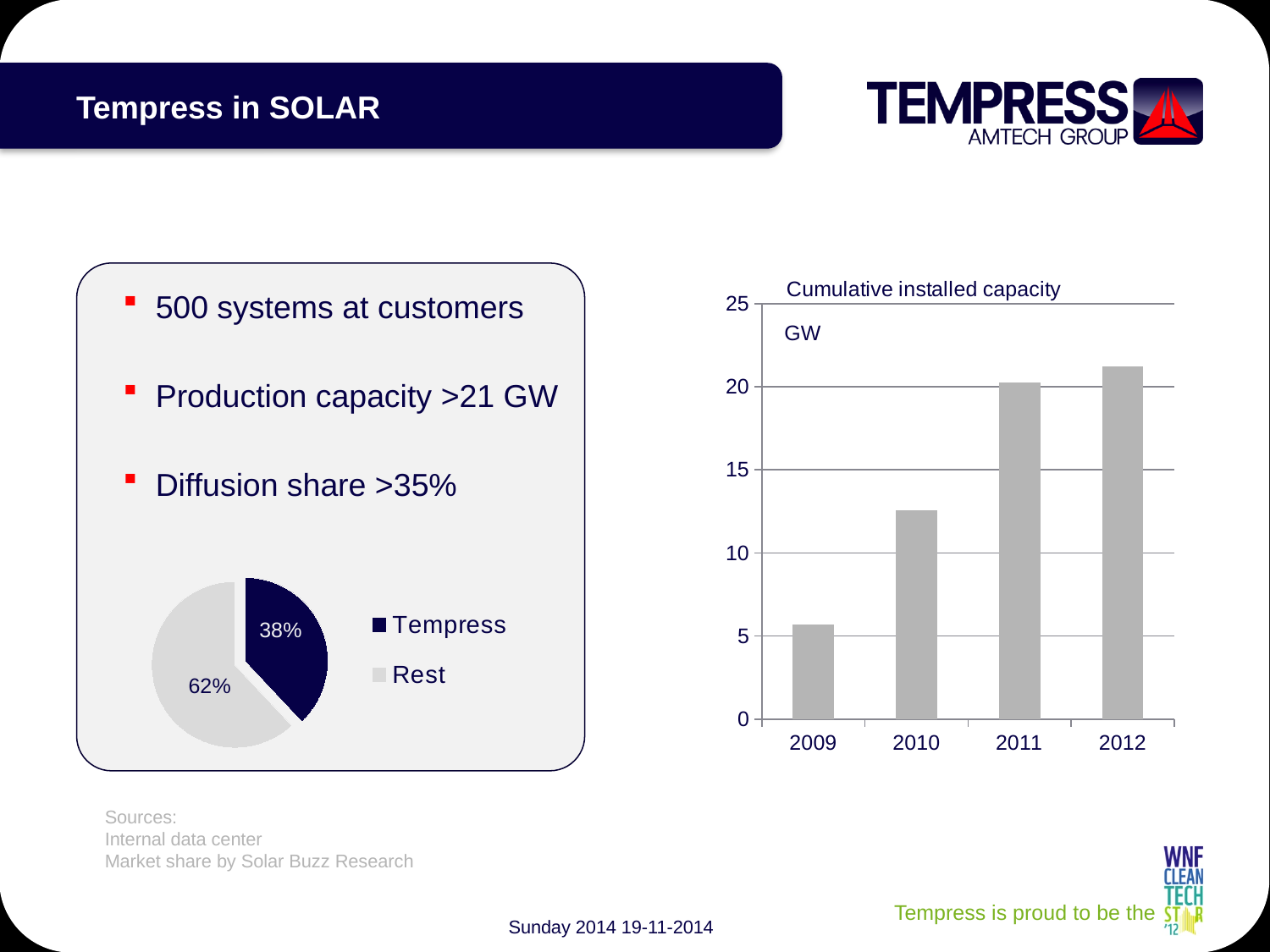
In the pie chart, how many entries does the legend list? 2 In the pie chart, what share does Tempress hold? 38% In the pie chart, which slice is larger, Tempress or Rest? Rest In the Cumulative installed capacity chart, which year has the lowest value? 2009 In the Cumulative installed capacity chart, do the values rise or fall from 2009 to 2012? rise In the Cumulative installed capacity chart, which year has the highest value? 2012 What is the title of the bar chart on the right? Cumulative installed capacity In the pie chart, what share is labelled Rest? 62% In the pie chart, how many percentage points larger is the Rest slice than the Tempress slice? 24 What type of chart is the Cumulative installed capacity chart? bar chart In the Cumulative installed capacity chart, is the value for 2010 greater or less than 10? greater In the Cumulative installed capacity chart, how many years are shown on the x axis? 4